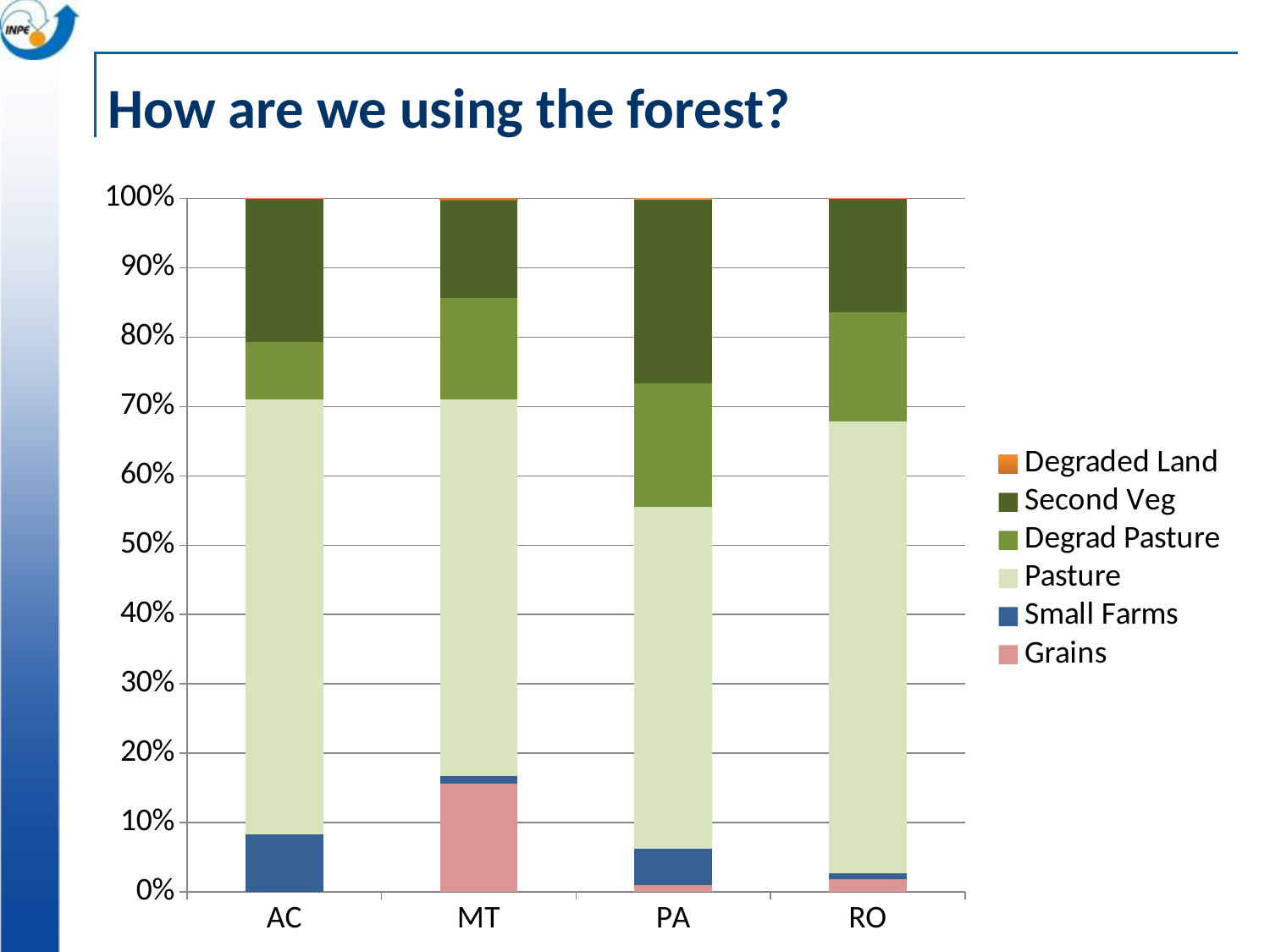
Which category has the largest Second Veg segment? PA Which category has the largest Small Farms segment? AC What does each stacked bar in the chart total? 100% Which category has the largest Grains segment? MT What is the title of the slide containing the chart? How are we using the forest? What kind of chart is shown on the slide? Stacked bar chart Which legend entry is shown in orange? Degraded Land Is the Grains segment for MT greater or less than 10%? greater Is the Small Farms segment for AC greater or less than 10%? less How many categories are shown on the x axis of the chart? 4 Which has the larger Degrad Pasture segment, PA or AC? PA How many series does the chart's legend list? 6